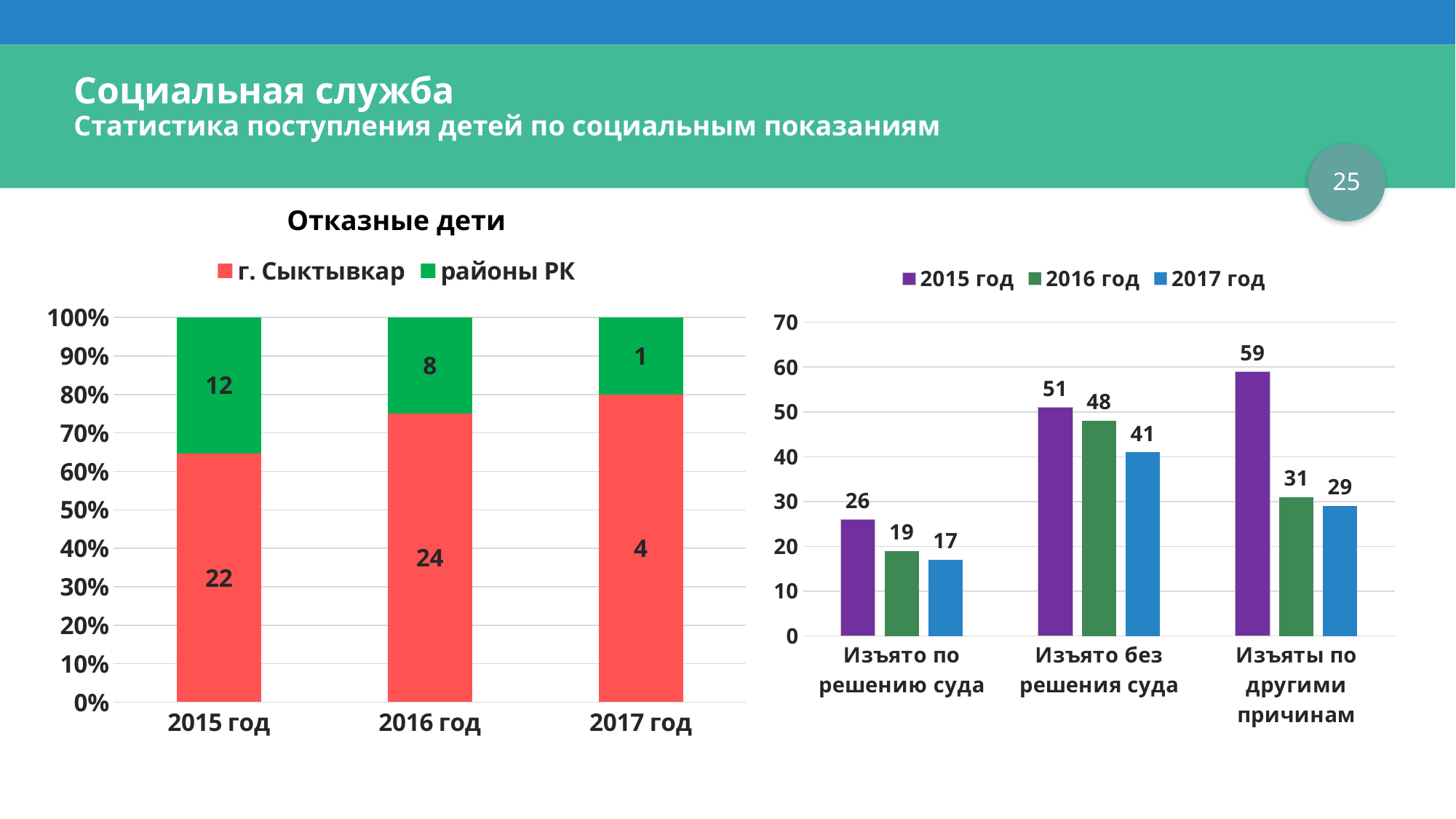
In the chart on the right, which category has the lowest value for 2017 год? Изъято по решению суда In the 'Отказные дети' chart, how many series does the legend list? 2 In the chart on the right, which is larger: the 2016 год value for 'Изъято по решению суда' or the 2017 год value for the same category? 2016 год In the 'Отказные дети' chart, what is the value for районы РК in 2017 год? 1 In the chart on the right, what is the value for 2016 год in the category 'Изъято без решения суда'? 48 In the 'Отказные дети' chart, what is the total of the 2015 год bar (г. Сыктывкар plus районы РК)? 34 In the 'Отказные дети' chart, what is the value for г. Сыктывкар in 2016 год? 24 In the chart on the right, how many categories are shown on the x axis? 3 In the chart on the right, which category has the highest value for 2015 год? Изъяты по другими причинам In the 'Отказные дети' chart, what kind of chart is it? Stacked bar chart In the 'Отказные дети' chart, do the values for районы РК rise or fall from 2015 год to 2017 год? Fall In the chart on the right, what is the difference between the 2015 год and 2017 год values for 'Изъяты по другим причинам'? 30